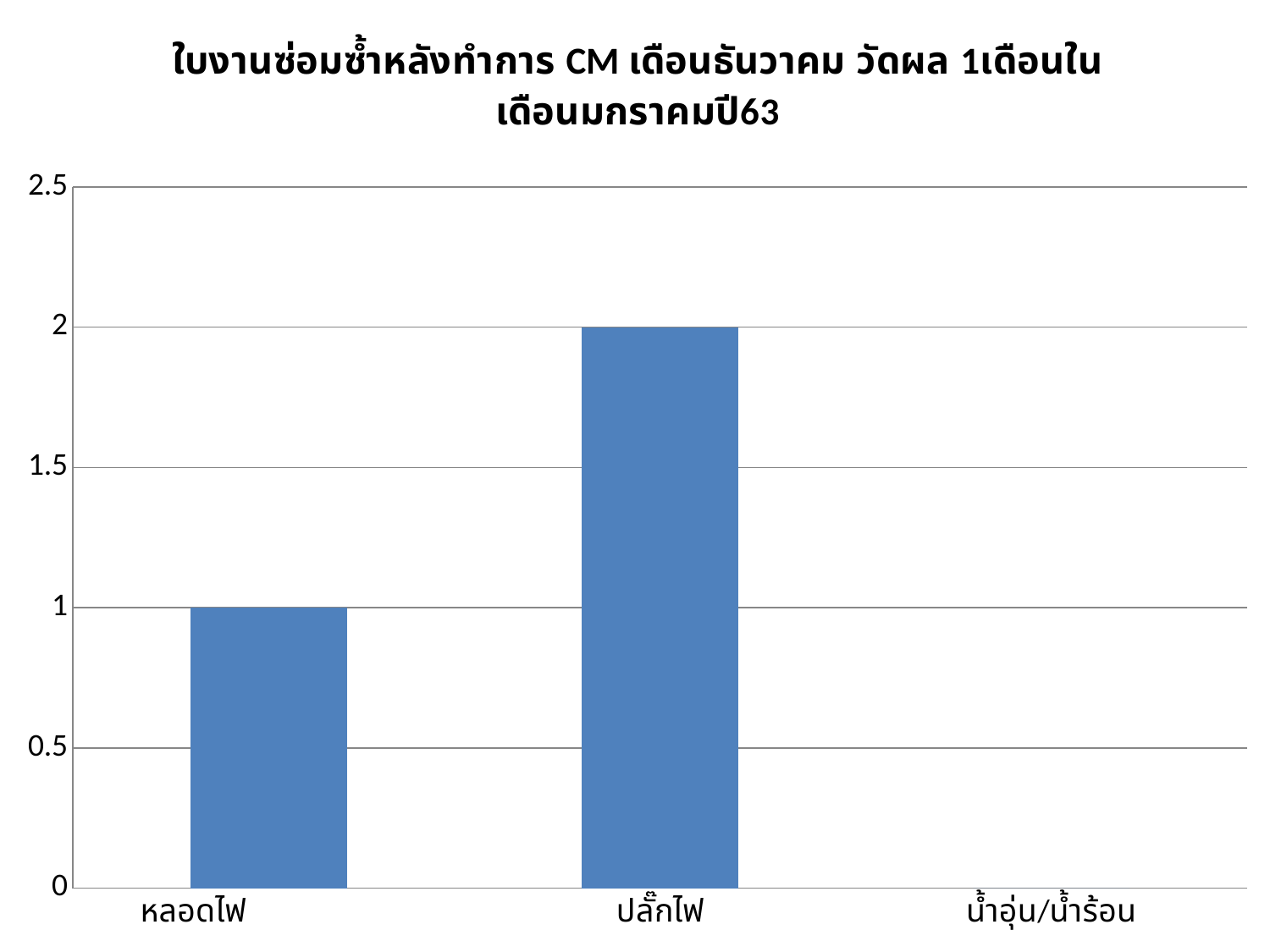
Which category has the lowest value? น้ำอุ่น/น้ำร้อน What is the difference between the values for ปลั๊กไฟ and หลอดไฟ? 1 How many categories are shown on the x axis? 3 Is the value for ปลั๊กไฟ greater or less than 1.5? greater What kind of chart is shown on the slide? bar chart What is the value for น้ำอุ่น/น้ำร้อน? 0 Is the value for หลอดไฟ greater or less than 1.5? less Which is larger, the value for หลอดไฟ or the value for ปลั๊กไฟ? ปลั๊กไฟ What is the value for หลอดไฟ? 1 What is the value for ปลั๊กไฟ? 2 What is the title of the chart? ใบงานซ่อมซ้ำหลังทำการ CM เดือนธันวาคม วัดผล 1เดือนในเดือนมกราคมปี63 Which category has the highest value? ปลั๊กไฟ